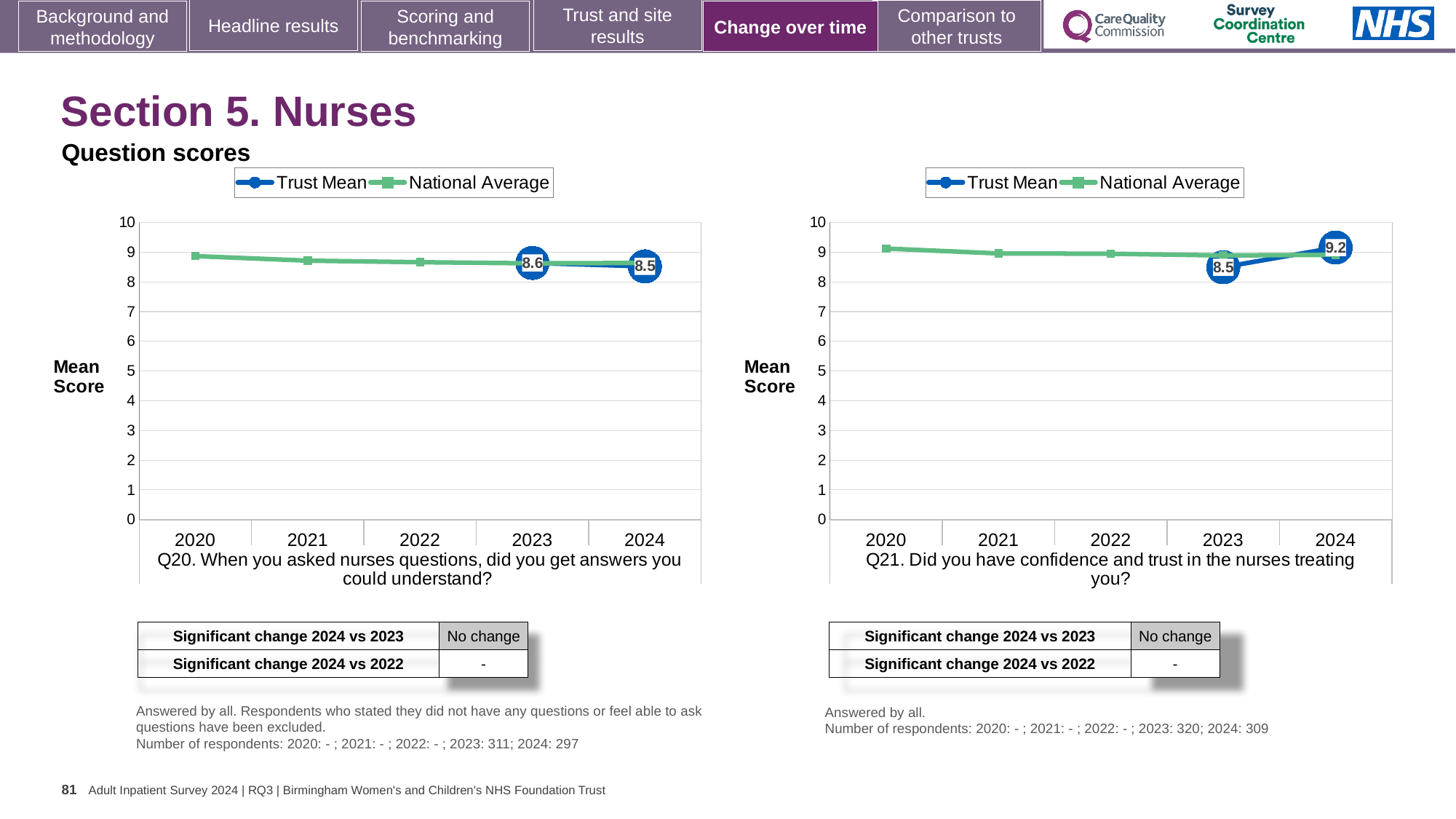
On the right chart (Q21), did the Trust Mean rise or fall from 2023 to 2024? rise On the left chart (Q20), by how much did the Trust Mean change from 2023 to 2024? 0.1 How many years are shown on the x axis of the right chart (Q21)? 5 How many series does the legend of the left chart (Q20) list? 2 On the right chart (Q21), which year has the higher Trust Mean, 2023 or 2024? 2024 On the right chart (Q21), what is the Trust Mean score for 2024? 9.2 On the left chart (Q20), what is the Trust Mean score for 2024? 8.5 On the left chart (Q20), is the National Average for 2020 greater or less than 8? greater On the right chart (Q21), what is the Trust Mean score for 2023? 8.5 On the right chart (Q21), by how much did the Trust Mean change from 2023 to 2024? 0.7 What type of chart is the left chart (Q20)? line chart On the left chart (Q20), what is the Trust Mean score for 2023? 8.6